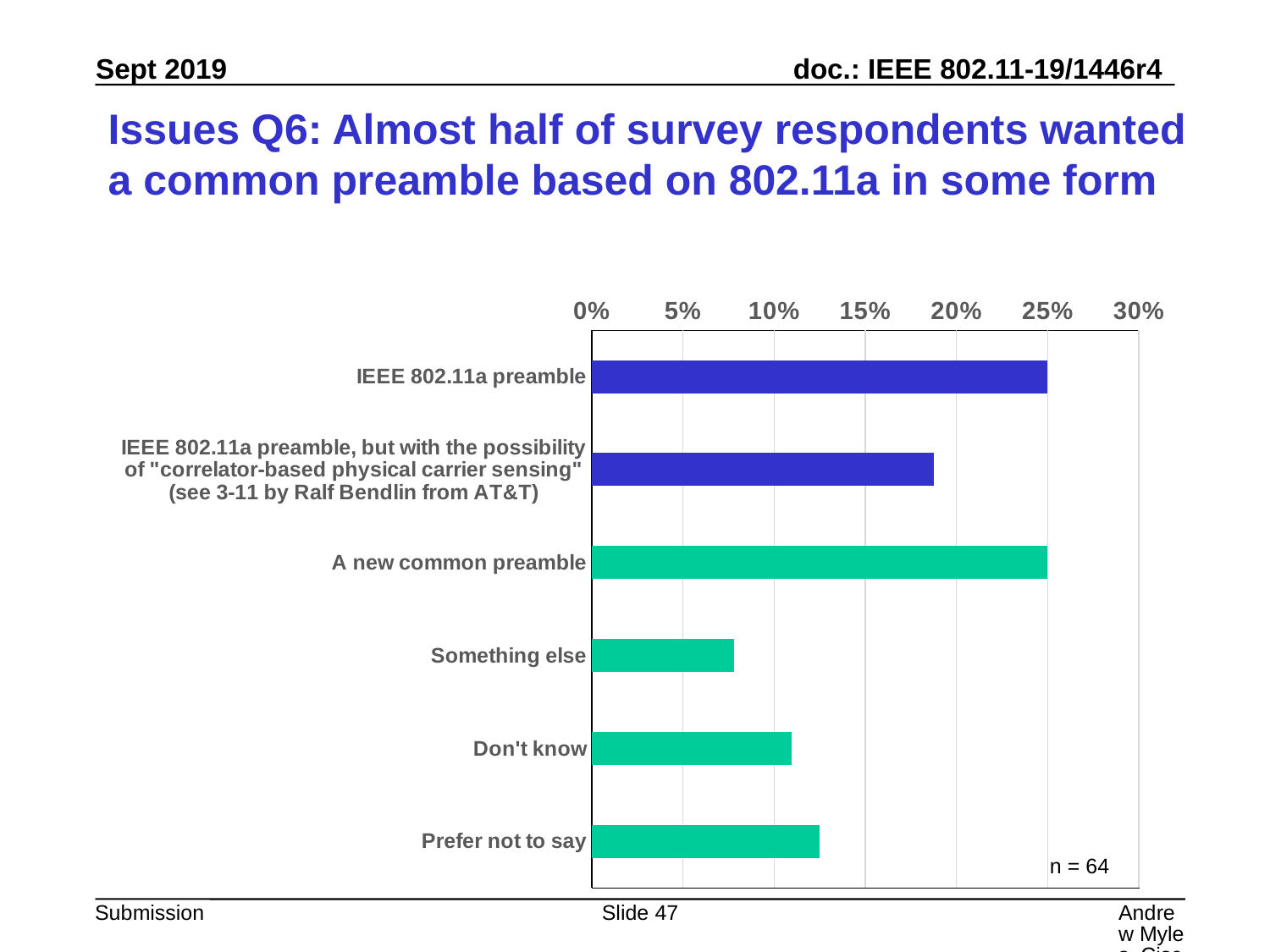
What kind of chart is shown on the slide? bar chart Is the value for "IEEE 802.11a preamble, but with the possibility of 'correlator-based physical carrier sensing'" greater or less than 20%? less Is the value for "IEEE 802.11a preamble, but with the possibility of 'correlator-based physical carrier sensing'" greater or less than 15%? greater Is the value for "Something else" greater or less than 10%? less Which is larger, the value for "Don't know" or the value for "Something else"? Don't know What is the value for "IEEE 802.11a preamble"? 25% What is the value for "A new common preamble"? 25% How many categories are plotted in the chart? 6 Which category has the lowest value in the chart? Something else How many bars in the chart are coloured blue? 2 What is the sample size (n) noted on the chart? n = 64